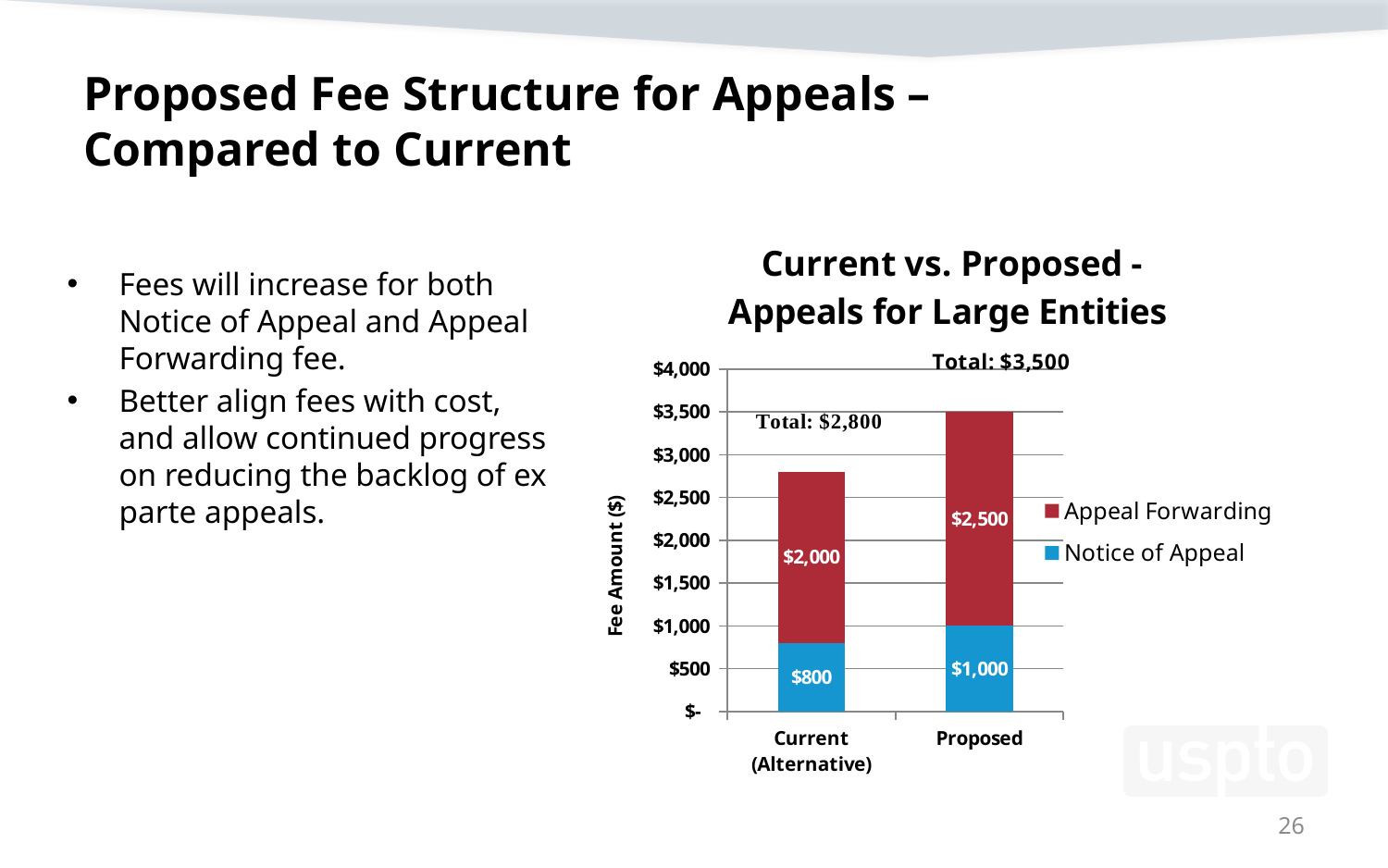
What is the Notice of Appeal fee for the Current (Alternative) category? $800 What kind of chart is shown on the slide? Stacked bar chart What is the difference between the Proposed and Current (Alternative) Appeal Forwarding fees? $500 Which category has the higher total fee, Current (Alternative) or Proposed? Proposed What is the title of the chart? Current vs. Proposed - Appeals for Large Entities How many categories are shown on the x axis? 2 What is the Appeal Forwarding fee for the Proposed category? $2,500 How many series does the legend list? 2 What is the Appeal Forwarding fee for the Current (Alternative) category? $2,000 What is the total fee for the Current (Alternative) stacked bar? $2,800 What is the total fee for the Proposed stacked bar? $3,500 What is the Notice of Appeal fee for the Proposed category? $1,000